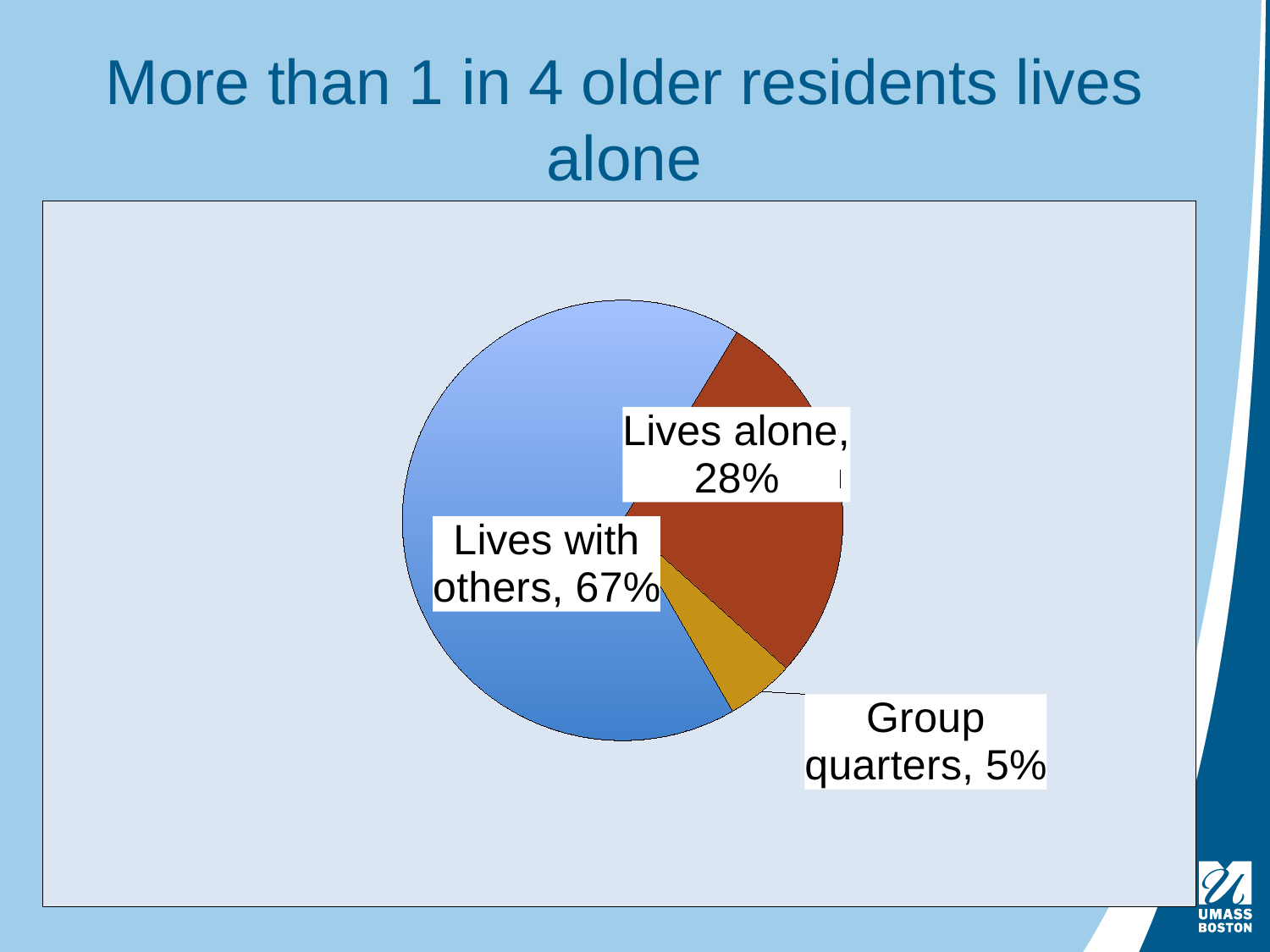
How many percentage points larger is the share for 'Lives with others' than for 'Lives alone'? 39 How many slices does the pie chart have? 3 What share of older residents lives in group quarters? 5% Which living arrangement has the largest share of the pie? Lives with others Which is larger: the share for 'Lives alone' or the share for 'Group quarters'? Lives alone What colour is the 'Group quarters' slice of the pie? Gold/yellow What kind of chart is shown on the slide? Pie chart How many percentage points larger is the share for 'Lives alone' than for 'Group quarters'? 23 What is the title of the slide containing the chart? More than 1 in 4 older residents lives alone What share of older residents lives with others? 67% Which living arrangement has the smallest share of the pie? Group quarters What share of older residents lives alone? 28%